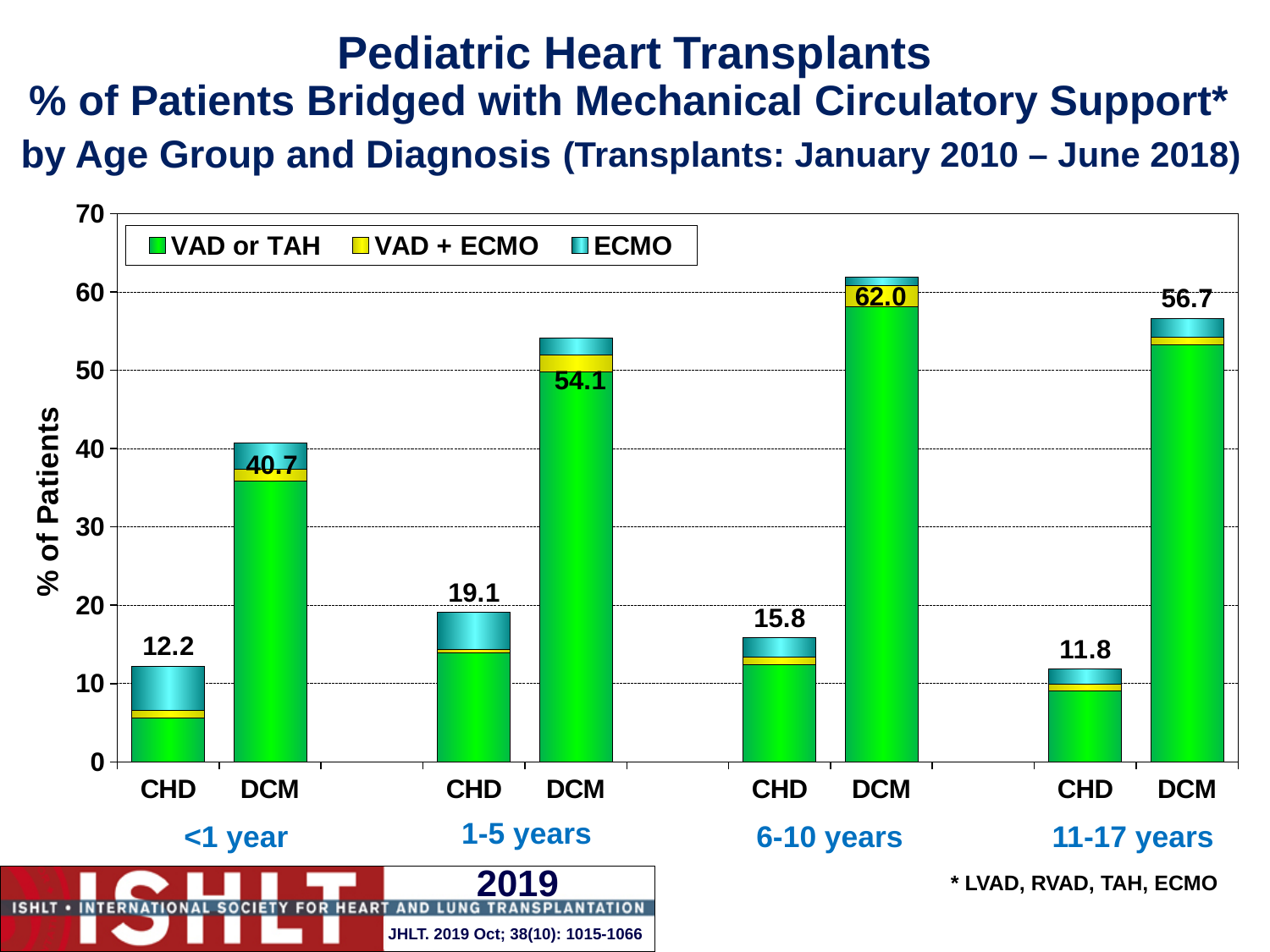
Which bar has the lowest total percentage of patients bridged? CHD, 11-17 years Which bar has the highest total percentage of patients bridged? DCM, 6-10 years What is the total percentage for DCM in the 11-17 years age group? 56.7 How many series does the legend list? 3 What is the total percentage for CHD in the <1 year age group? 12.2 What kind of chart is shown on the slide? Stacked bar chart Which series is shown in yellow in the legend? VAD + ECMO What is the total percentage of patients bridged with mechanical circulatory support for DCM in the 6-10 years age group? 62.0 Which is larger, the CHD total for 1-5 years or the CHD total for 6-10 years? 1-5 years Is the total for DCM in the <1 year age group greater or less than 40? greater How many bars are plotted on the chart? 8 What is the difference between the DCM and CHD totals in the 1-5 years age group? 35.0